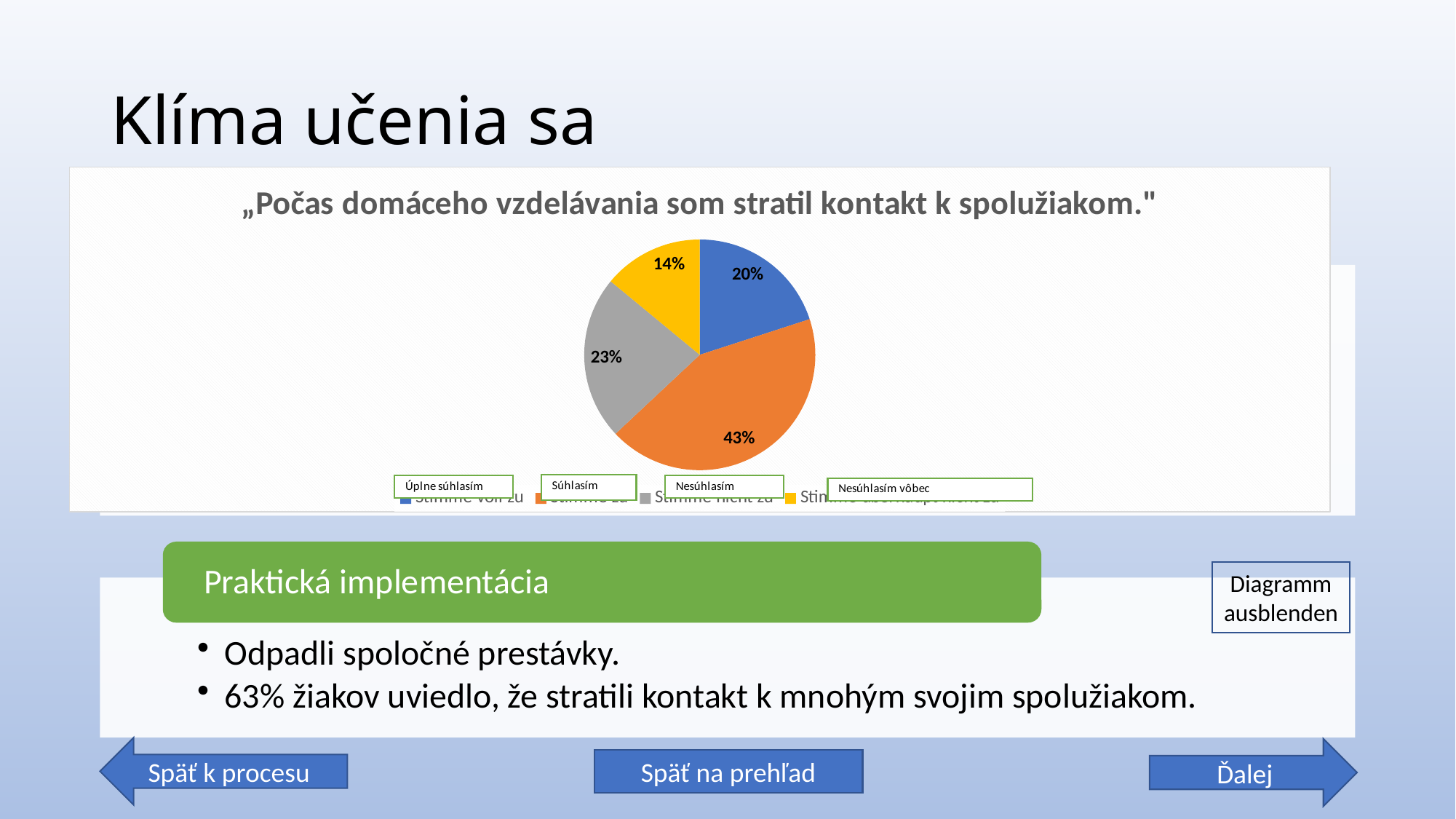
Which slice is larger, "Nesúhlasím" or "Úplne súhlasím"? Nesúhlasím What share of the pie does the "Súhlasím" slice represent? 43% What is the combined share of the "Úplne súhlasím" and "Súhlasím" slices? 63% What share of the pie does the "Nesúhlasím vôbec" slice represent? 14% How many slices does the pie chart have? 4 What share of the pie does the "Úplne súhlasím" slice represent? 20% What colour is the "Súhlasím" slice in the pie chart? orange What is the difference in percentage points between the "Súhlasím" and "Nesúhlasím" slices? 20 Which category has the largest slice of the pie? Súhlasím Which category has the smallest slice of the pie? Nesúhlasím vôbec What kind of chart is shown on the slide? pie chart